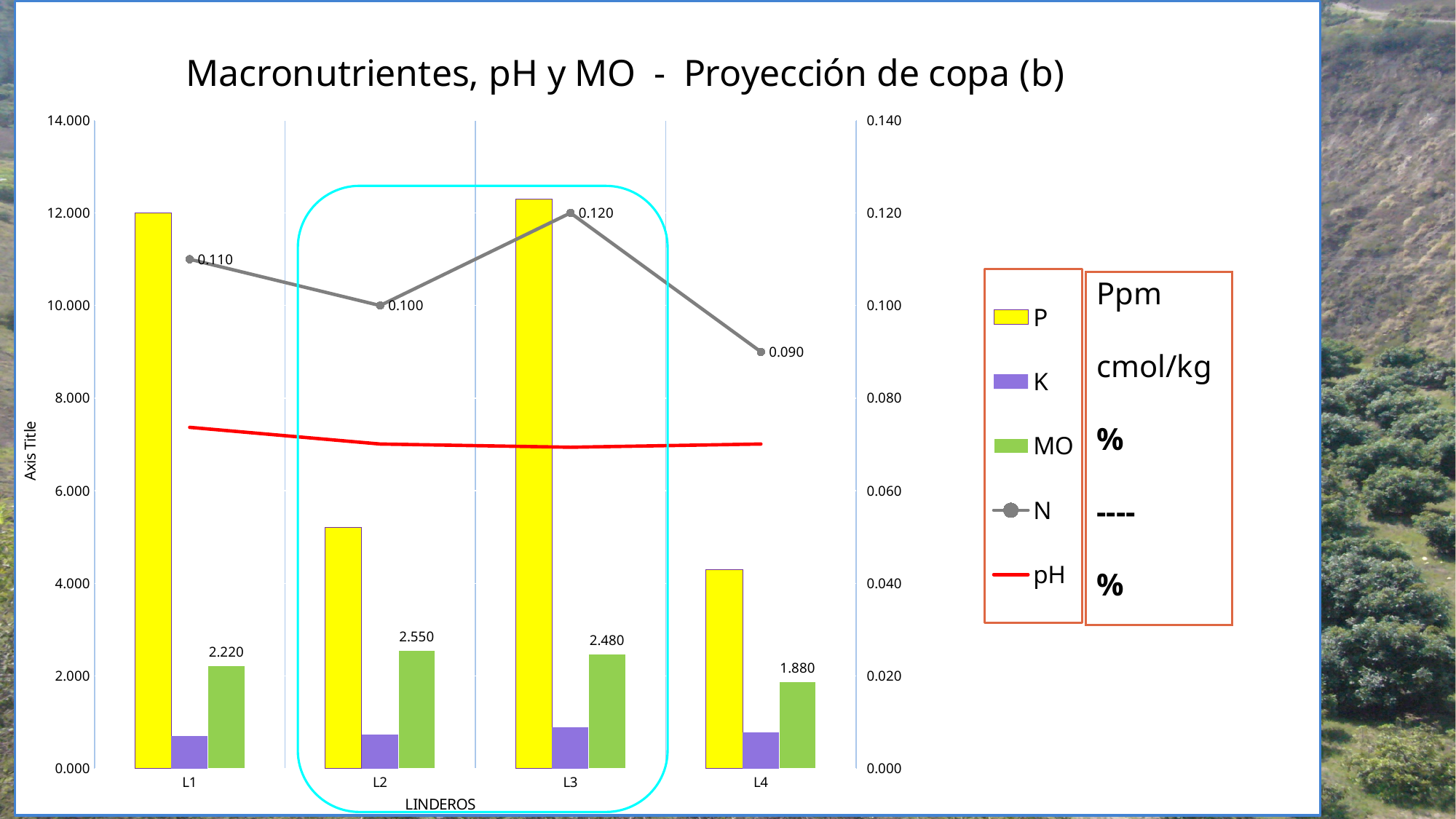
How many series does the legend list? 5 Is the value for P at L4 greater or less than 6.000? less Is the value for P at L1 greater or less than 10.000? greater How many linderos (categories) are shown on the x axis? 4 What is the value of MO at L4? 1.880 Which has a higher N value, L1 or L2? L1 What kind of chart is this? Combination bar and line chart At which lindero is N lowest? L4 At which lindero is MO highest? L2 What is the value of N at L3? 0.120 What is the value of MO at L2? 2.550 What is the difference between the MO values at L2 and L4? 0.670